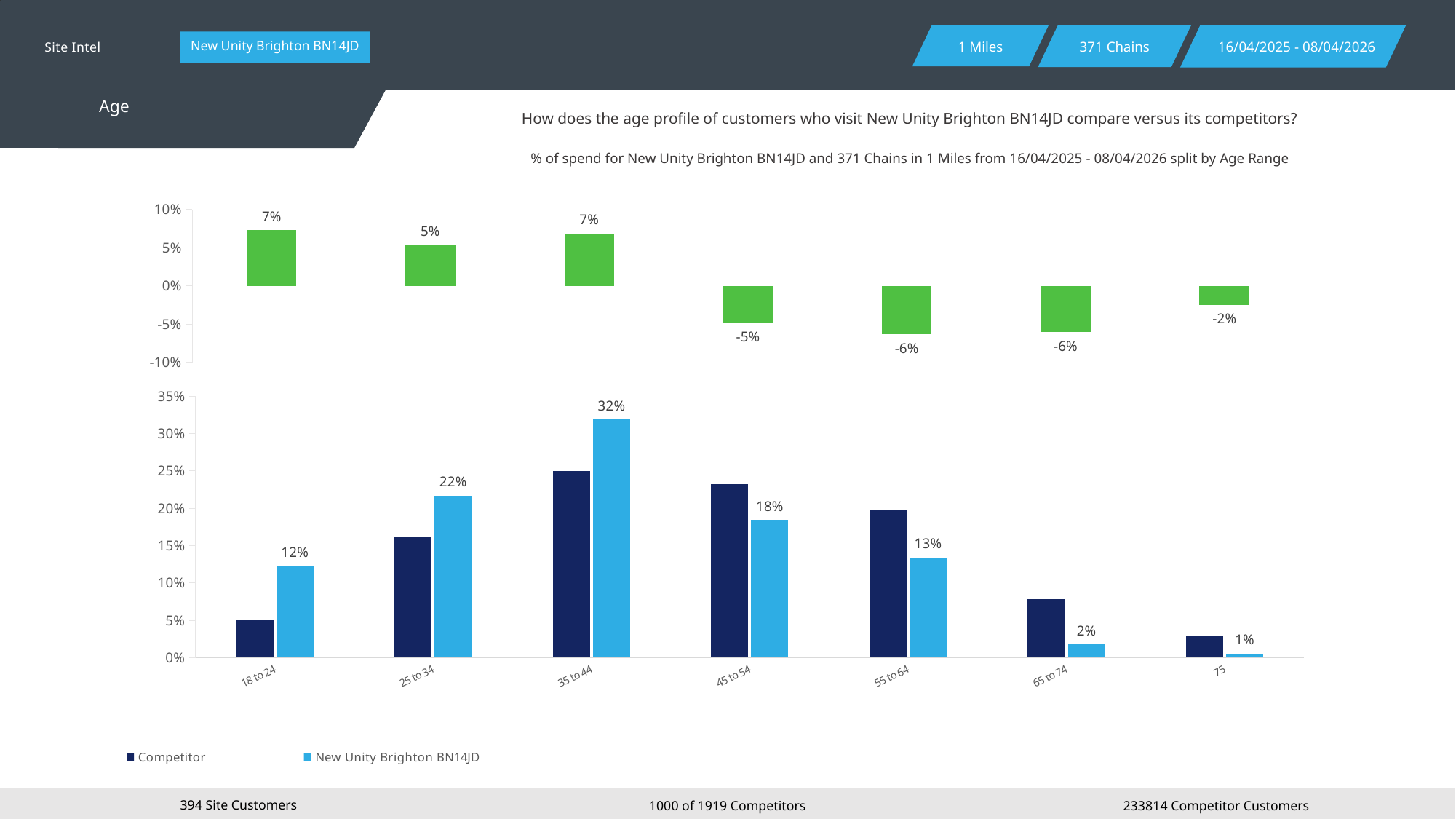
How many series does the legend of the bottom chart list? 2 In the bottom chart, what is the difference between the New Unity Brighton BN14JD values for 35 to 44 and 45 to 54? 14% In the bottom chart, which age range has the highest value for New Unity Brighton BN14JD? 35 to 44 In the bottom chart, what is the value for New Unity Brighton BN14JD in the 18 to 24 age range? 12% How many age ranges are shown on the x axis of the bottom chart? 7 In the top chart, what is the value shown for the 55 to 64 age range? -6% In the bottom chart, for the 55 to 64 age range, which series has the larger value: Competitor or New Unity Brighton BN14JD? Competitor In the bottom chart, what is the value for New Unity Brighton BN14JD in the 35 to 44 age range? 32% In the bottom chart, is the Competitor value for 35 to 44 greater or less than 20%? greater In the bottom chart, which age range has the lowest value for New Unity Brighton BN14JD? 75 What type of chart is the bottom chart? Bar chart In the top chart, what is the value shown for the 25 to 34 age range? 5%